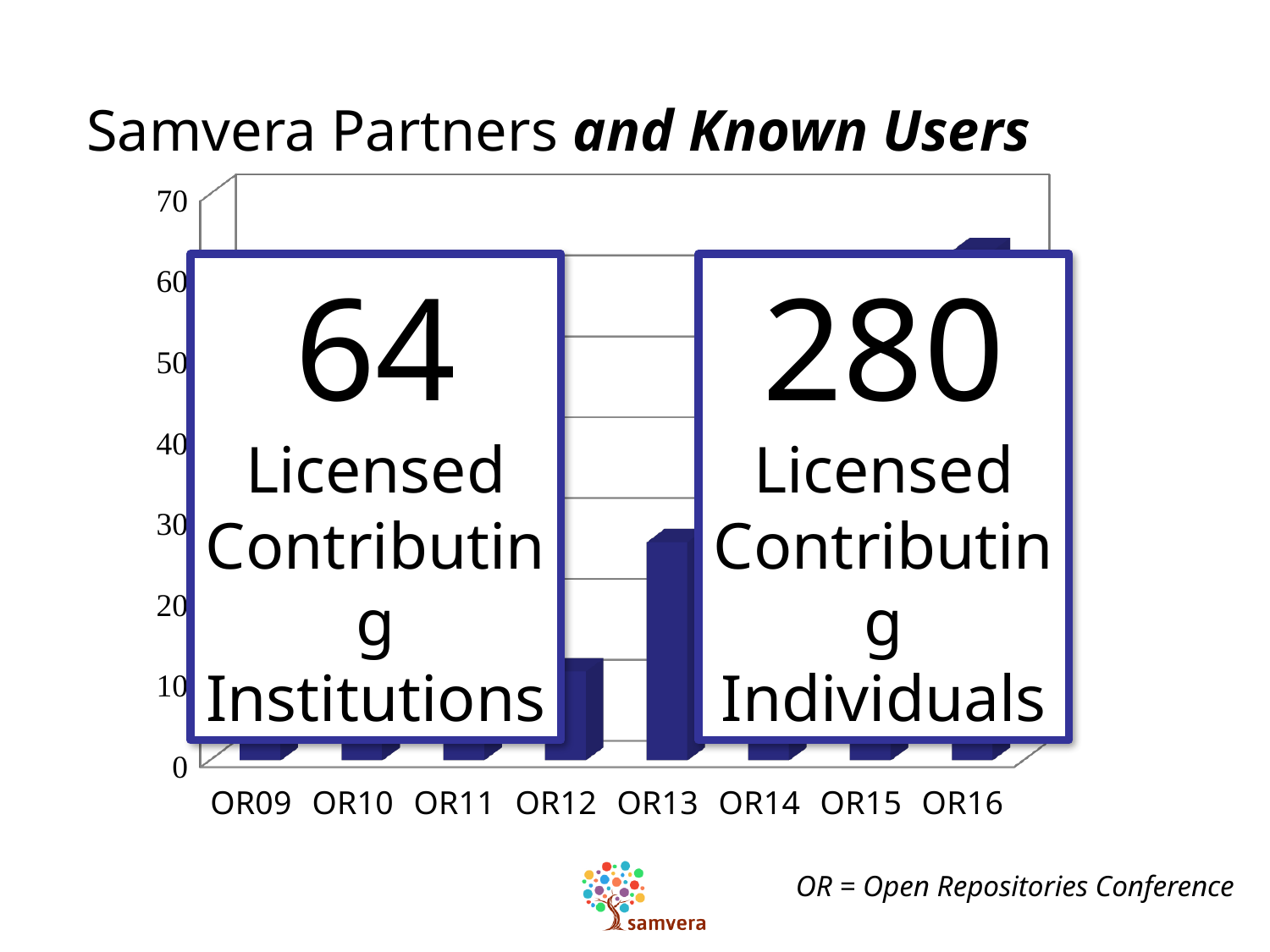
Is the value for OR12 greater or less than 20? less What is the highest value shown on the y axis of the chart? 70 What is the title of the chart on the slide? Samvera Partners and Known Users Which is larger, the value for OR12 or the value for OR13? OR13 What is the first category label on the x axis of the chart? OR09 Is the value for OR16 greater or less than 60? greater Which category has the highest bar in the chart? OR16 What type of chart is shown on the slide? bar chart Is the value for OR13 greater or less than 40? less How many categories are shown on the x axis of the chart? 8 Do the visible bar values rise or fall from OR12 to OR16? rise